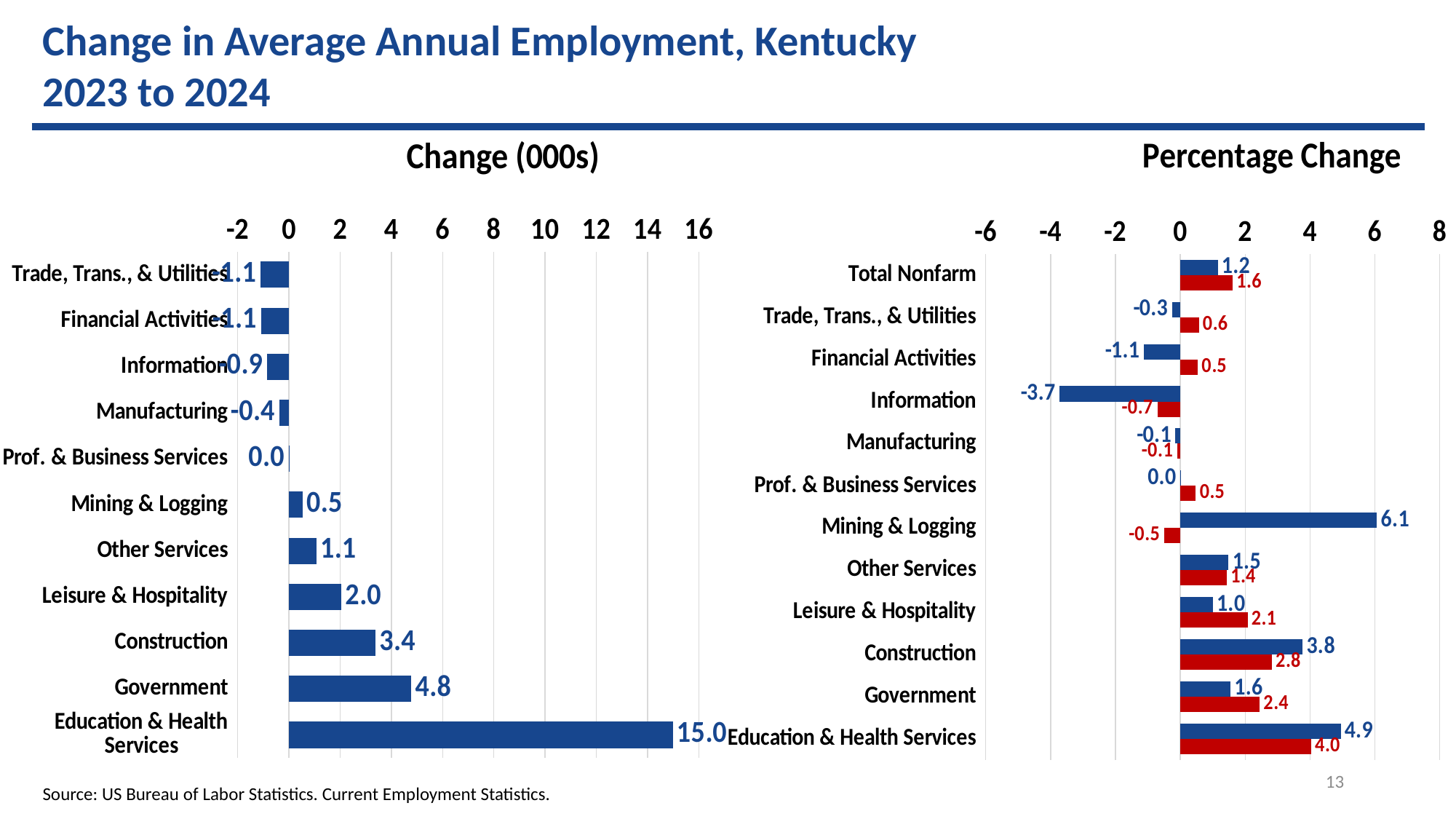
In the 'Change (000s)' chart, which category has the lowest value? Trade, Trans., & Utilities and Financial Activities (both -1.1) In the 'Change (000s)' chart, how many categories are shown? 11 In the 'Percentage Change' chart, which category has the lowest blue bar value? Information In the 'Change (000s)' chart, what is the difference between Education & Health Services and Government? 10.2 In the 'Change (000s)' chart, what is the value for Education & Health Services? 15.0 In the 'Percentage Change' chart, what is the blue bar value for Mining & Logging? 6.1 What kind of chart is the 'Change (000s)' chart? Bar chart In the 'Percentage Change' chart, how many categories are shown? 12 In the 'Percentage Change' chart, what is the red bar value for Education & Health Services? 4.0 In the 'Change (000s)' chart, what is the value for Government? 4.8 In the 'Percentage Change' chart, what is the difference between the blue and red bar values for Total Nonfarm? 0.4 In the 'Percentage Change' chart, which is larger for Construction, the blue bar or the red bar? Blue bar (3.8)